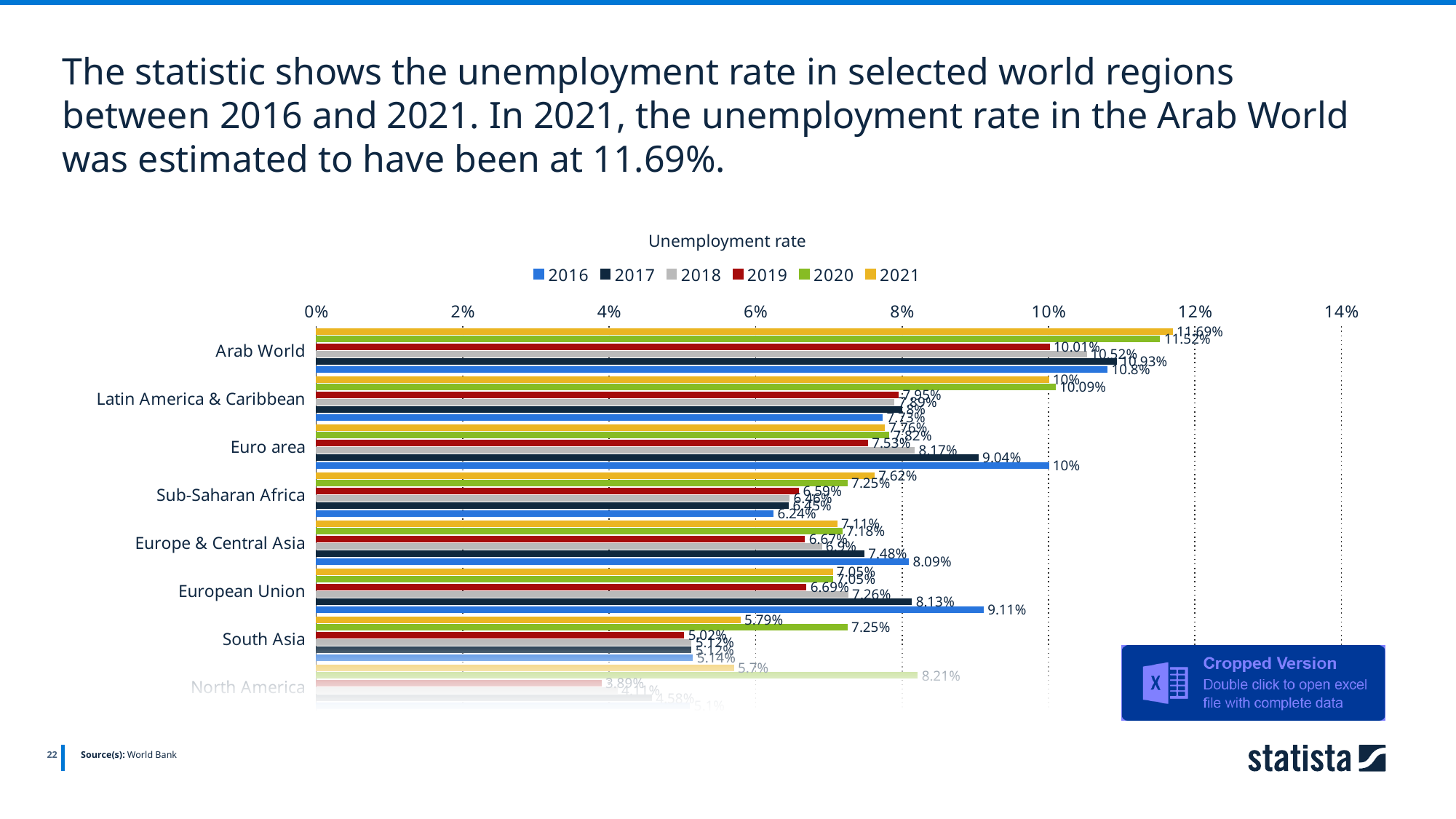
Which region had the highest unemployment rate in 2021? Arab World What was the unemployment rate in the Arab World in 2017? 10.93% What was the unemployment rate in the European Union in 2016? 9.11% Is the 2016 unemployment rate for Latin America & Caribbean greater or less than 6%? greater How many series does the legend of the chart list? 6 What was the unemployment rate in the Euro area in 2016? 10% What was the unemployment rate in the Arab World in 2021? 11.69% What is the title of the chart? Unemployment rate What was the unemployment rate in South Asia in 2020? 7.25% By how much did the Euro area unemployment rate fall from 2016 (10%) to 2017 (9.04%)? 0.96% Which was larger in 2016, the unemployment rate in the Euro area or in the European Union? Euro area What type of chart is shown on the slide? bar chart